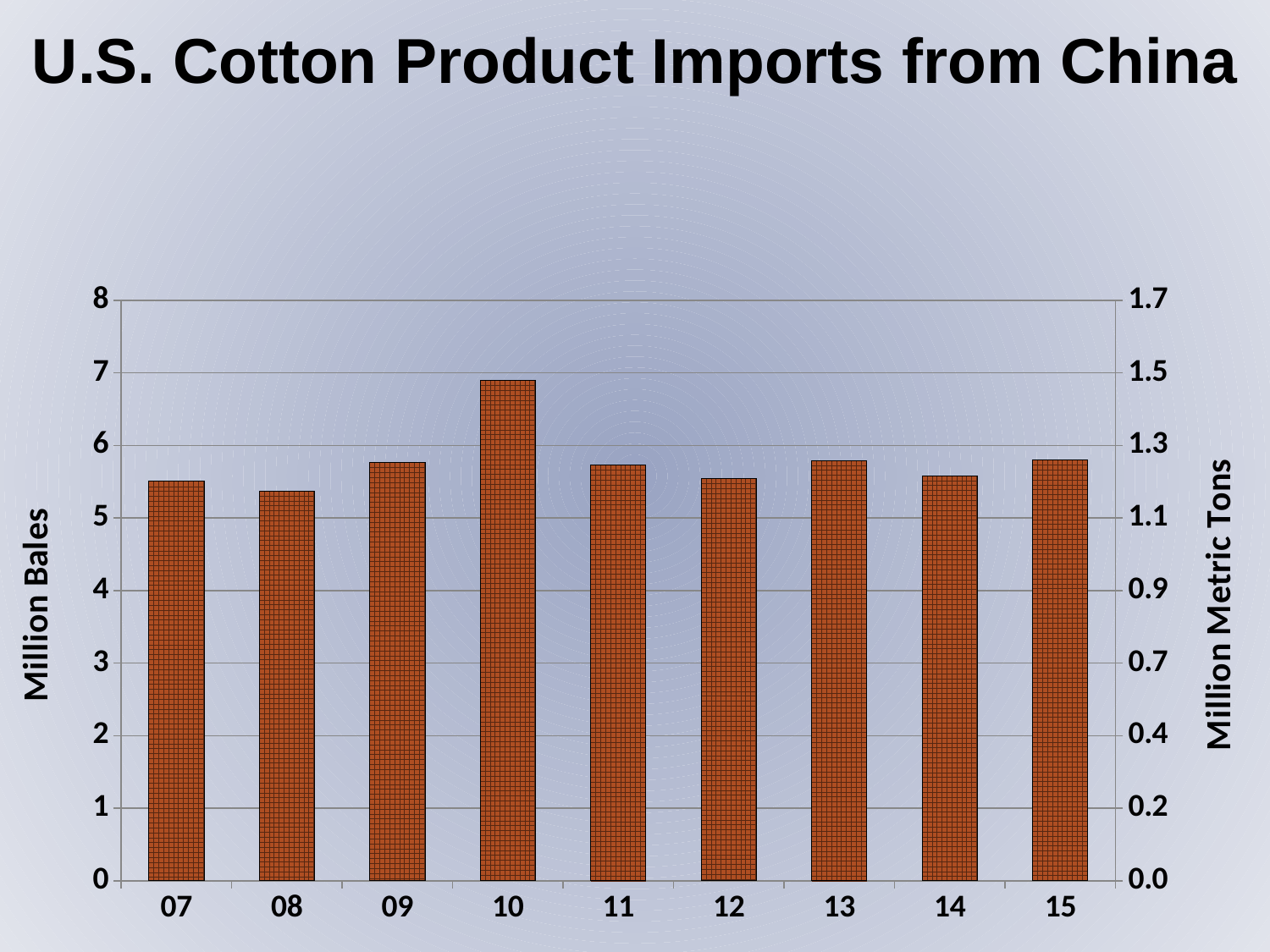
Is the value for 13 greater or less than 7 million bales? less Which year has the lowest U.S. cotton product imports from China? 08 Which year has the larger value, 10 or 08? 10 Which year has the larger value, 09 or 08? 09 What is the title of the chart? U.S. Cotton Product Imports from China Is the value for 07 greater or less than 5 million bales? greater Is the value for 08 greater or less than 6 million bales? less What kind of chart is shown on the slide? Bar chart Which year has the highest U.S. cotton product imports from China? 10 How many years (bars) are plotted on the chart? 9 What is the label on the left vertical axis? Million Bales